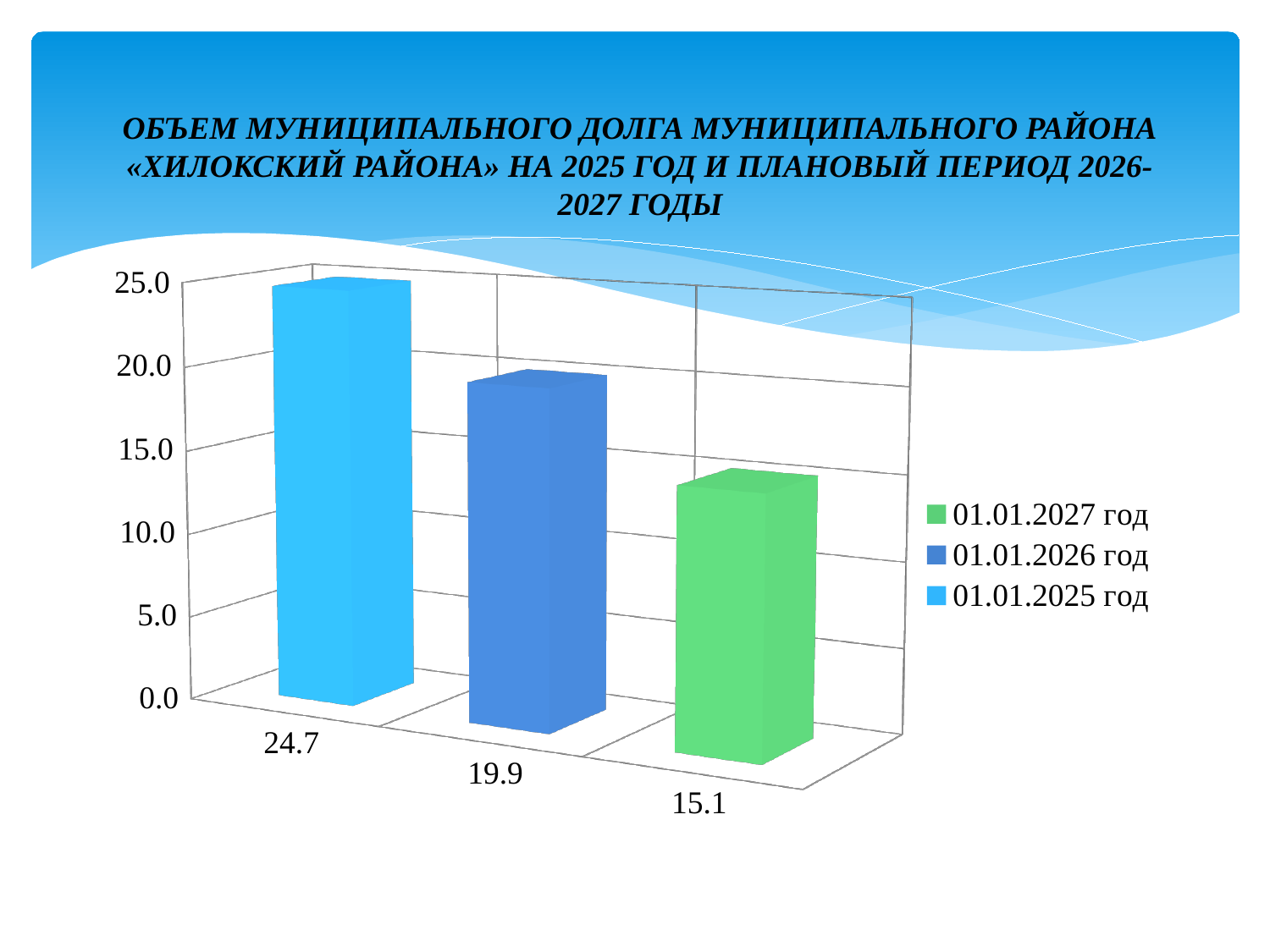
Is the value for 01.01.2026 год greater or less than 15.0? greater What is the value of municipal debt as of 01.01.2025 год? 24.7 What is the difference between the values for 01.01.2025 год and 01.01.2027 год? 9.6 What is the difference between the values for 01.01.2025 год and 01.01.2026 год? 4.8 What kind of chart is shown on the slide? Bar chart Which date has the lowest municipal debt value? 01.01.2027 год What is the value of municipal debt as of 01.01.2026 год? 19.9 How many bars are plotted on the chart? 3 How many entries does the legend list? 3 Which is larger, the value for 01.01.2026 год or the value for 01.01.2027 год? 01.01.2026 год Which date has the highest municipal debt value? 01.01.2025 год What is the value of municipal debt as of 01.01.2027 год? 15.1